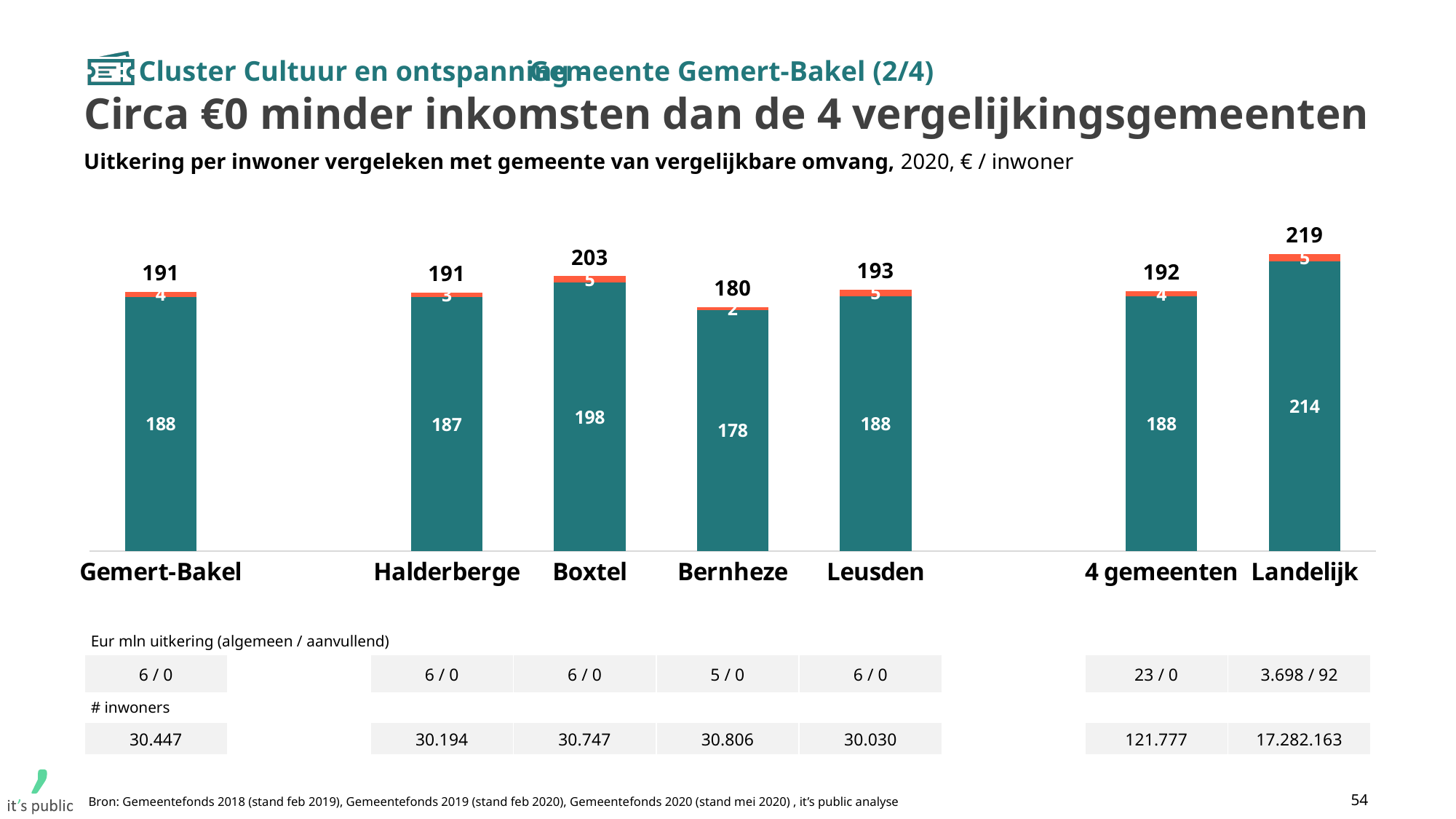
What is the value of the orange (upper) segment for Leusden? 5 What is the difference between the total for Landelijk and the total for Gemert-Bakel? 28 What is the value of the teal (lower) segment for Bernheze? 178 Which has a larger total value, Boxtel or Leusden? Boxtel How many categories are shown on the x axis? 7 What kind of chart is shown on the slide? Stacked bar chart What is the value of the teal (lower) segment for Landelijk? 214 What is the total value shown above the bar for Boxtel? 203 Which category has the lowest total value? Bernheze What is the difference between the teal segment for Boxtel and the teal segment for Halderberge? 11 What is the total value shown above the bar for 4 gemeenten? 192 Which category has the highest total value? Landelijk